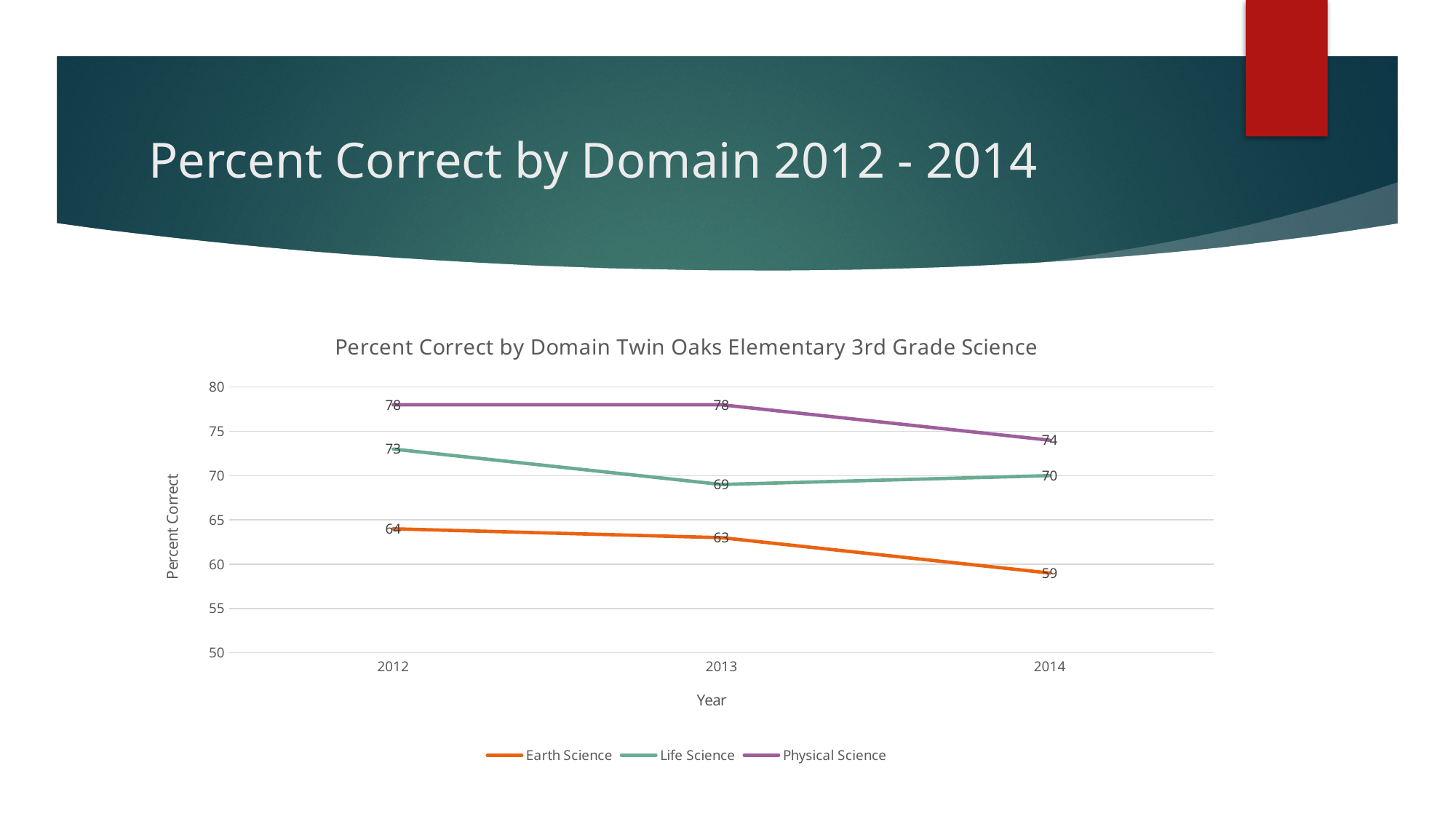
How many series does the legend list? 3 What is the difference between the Physical Science and Earth Science values in 2014? 15 Which is larger in 2013, Life Science or Earth Science? Life Science Is the Physical Science value for 2014 greater or less than 70? greater Which year has the highest Life Science value? 2012 What kind of chart is shown? line chart What is the Physical Science value for 2012? 78 What is the Life Science value for 2013? 69 How many years are shown on the x axis? 3 Does the Earth Science line rise or fall from 2012 to 2014? fall Which year has the lowest Earth Science value? 2014 What is the Earth Science value for 2014? 59